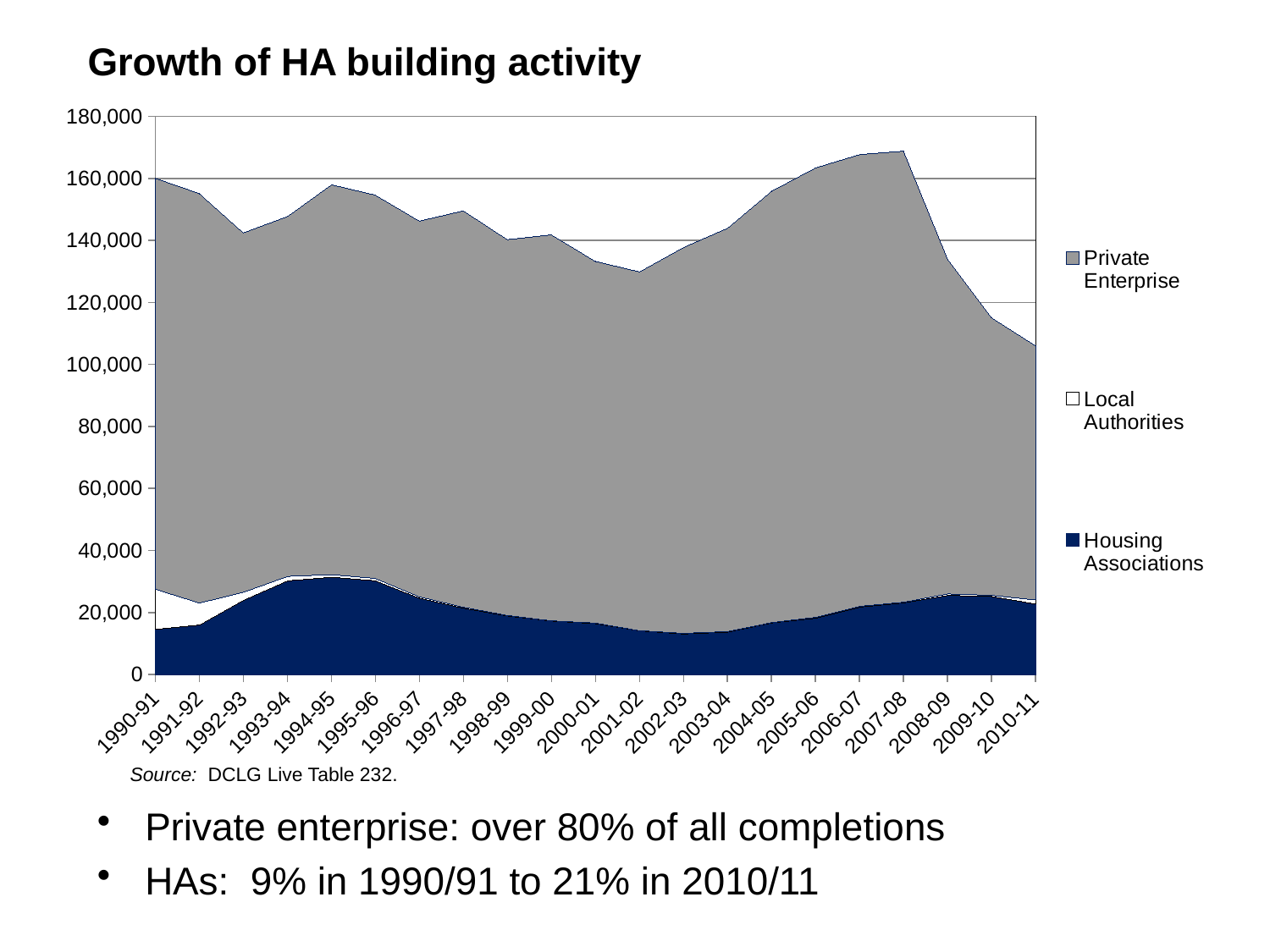
Is the total of all completions in 2007-08 greater or less than 160,000? greater Do total completions rise or fall from 2007-08 to 2010-11? fall What is the title of the slide? Growth of HA building activity How many series does the legend list? 3 In which year is the total of all completions highest? 2007-08 Which year has the larger total of completions, 1990-91 or 2010-11? 1990-91 Is the total of all completions in 2010-11 greater or less than 120,000? less What kind of chart is shown on the slide? Stacked area chart How many years are shown along the x axis? 21 In which year is the total of all completions lowest? 2010-11 Is the value for Housing Associations in 1990-91 greater or less than 20,000? less